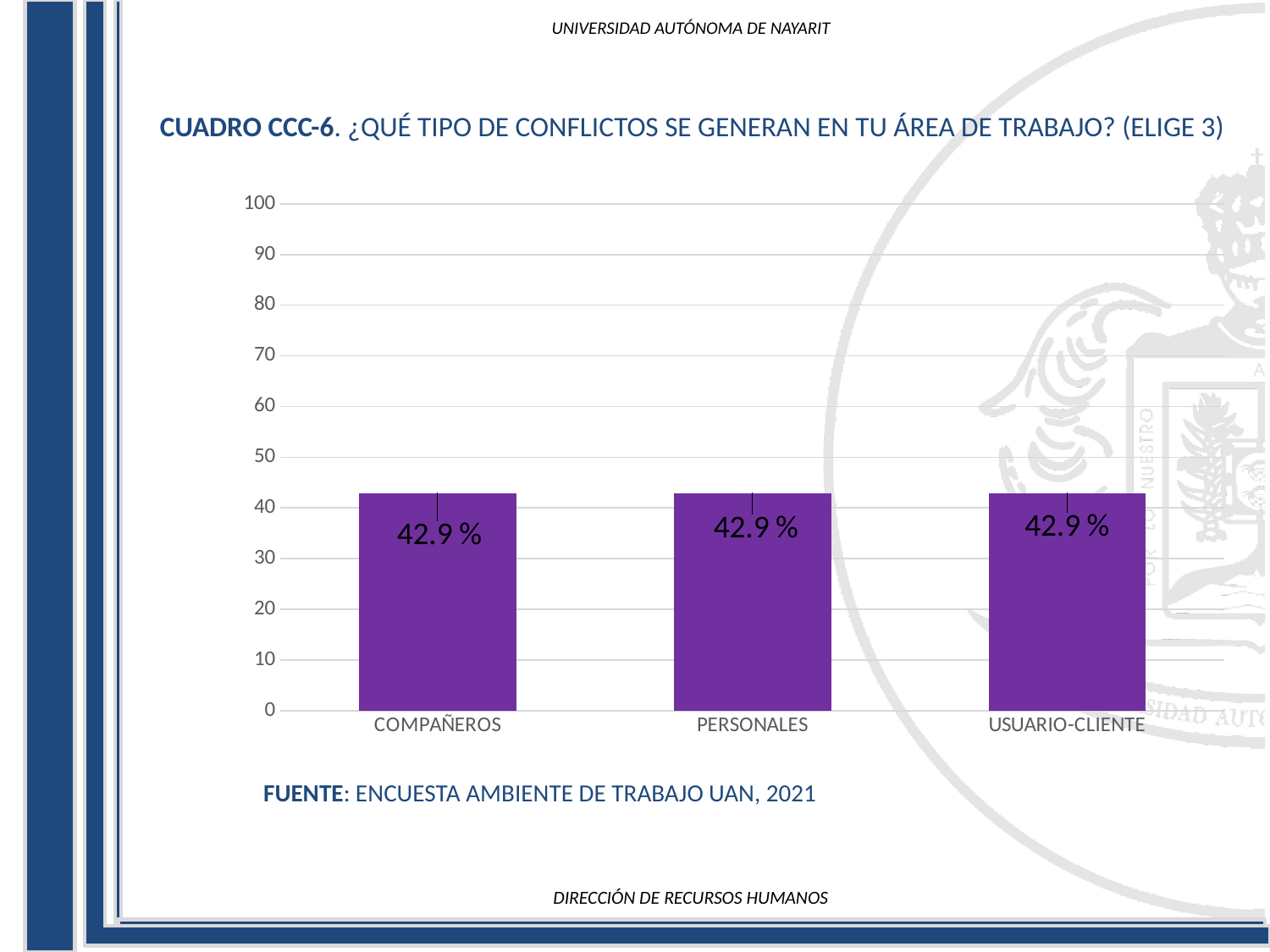
What is the value for COMPAÑEROS? 42.9 % What is the value for PERSONALES? 42.9 % How many categories are shown on the x axis? 3 What is the value for USUARIO-CLIENTE? 42.9 % Is the value for COMPAÑEROS greater or less than 40? greater What kind of chart is shown on the slide? bar chart What colour are the bars in the chart? purple Is the value for USUARIO-CLIENTE greater or less than 50? less Do the values rise, fall or stay the same across the categories from left to right? stay the same What is the highest value shown on the y axis? 100 What is the difference between the values for COMPAÑEROS and PERSONALES? 0